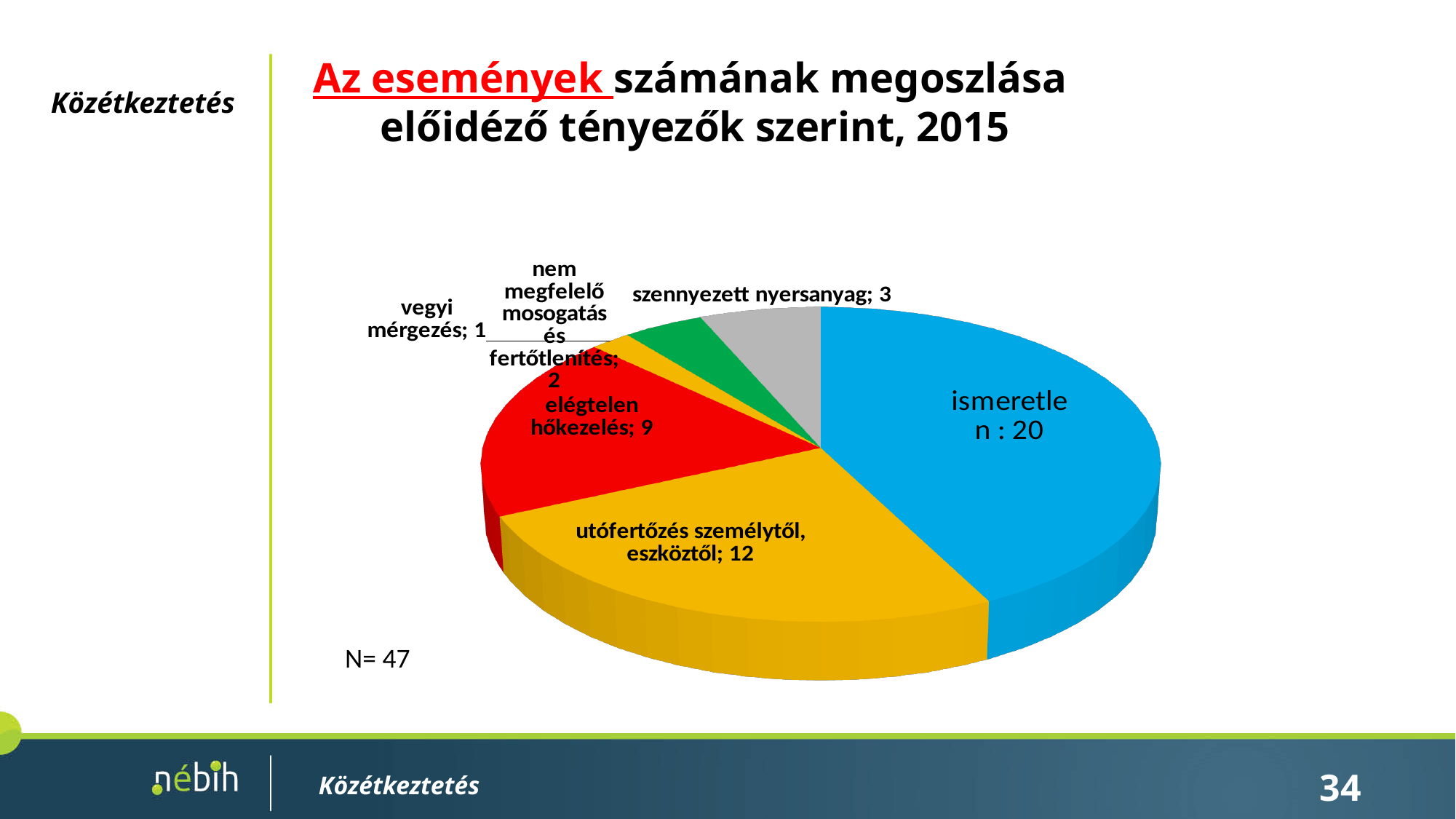
What is the value for "elégtelen hőkezelés"? 9 How many events are attributed to "ismeretlen" in the pie chart? 20 What is the value for "utófertőzés személytől, eszköztől"? 12 What kind of chart is shown on the slide? pie chart Which category has the smallest slice of the pie? vegyi mérgezés What is the difference between the values for "ismeretlen" and "utófertőzés személytől, eszköztől"? 8 How many categories does the pie chart show? 6 Which is larger: "elégtelen hőkezelés" or "szennyezett nyersanyag"? elégtelen hőkezelés What is the value for "nem megfelelő mosogatás és fertőtlenítés"? 2 What total N is stated on the slide for the pie chart? N= 47 Which category has the largest slice of the pie? ismeretlen What is the value for "szennyezett nyersanyag"? 3